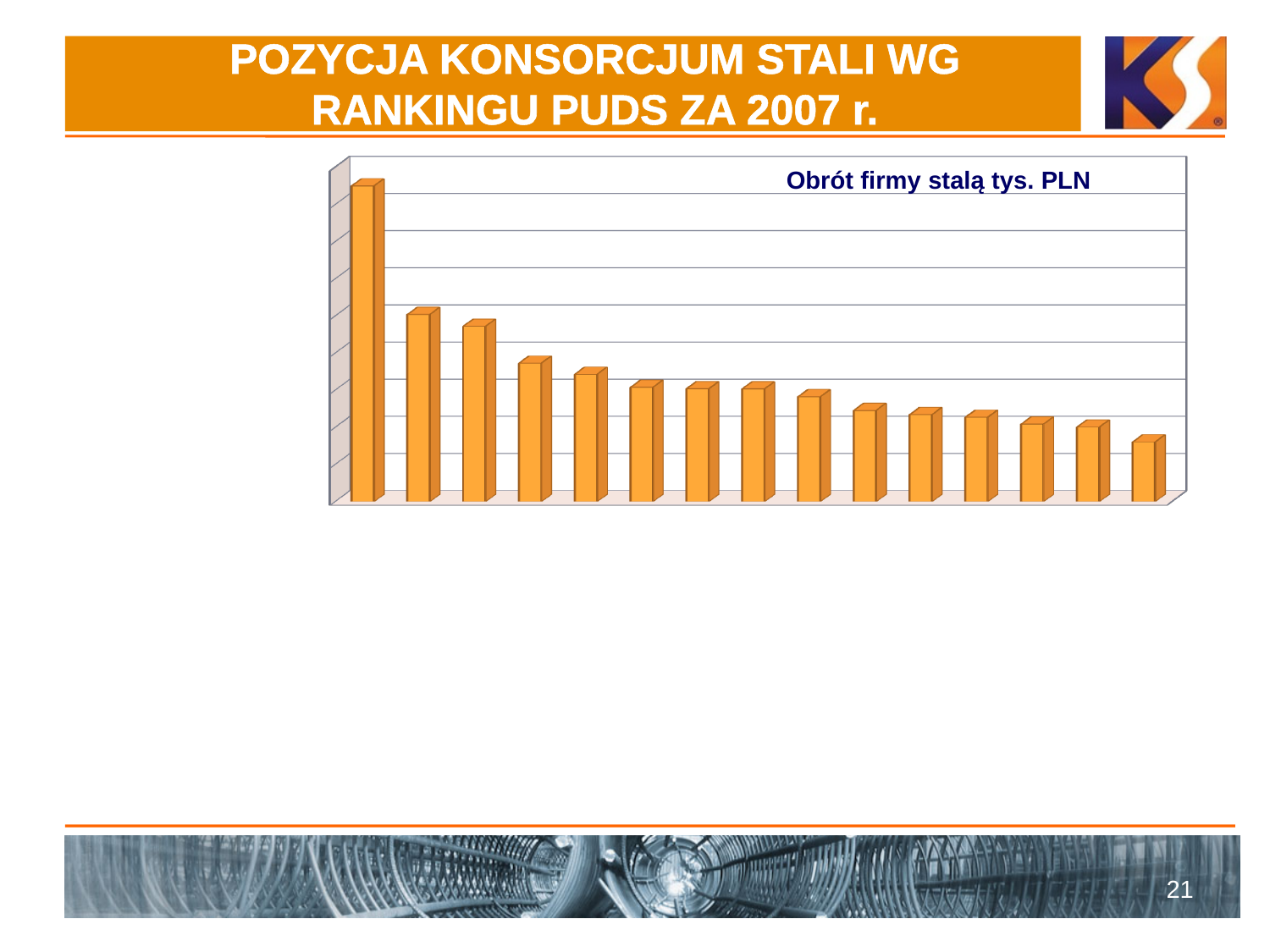
Do the bar values rise or fall from left to right across the chart? fall Which is larger, the second bar or the third bar from the left? the second bar What colour are the bars in the chart? orange What kind of chart is shown on the slide? bar chart Which bar is the tallest in the chart? the leftmost (first) bar Which bar is the shortest in the chart? the rightmost (last) bar Which is larger, the first bar or the second bar from the left? the first bar How many bars are plotted in the chart? 15 What is the title shown inside the chart area? Obrót firmy stalą tys. PLN